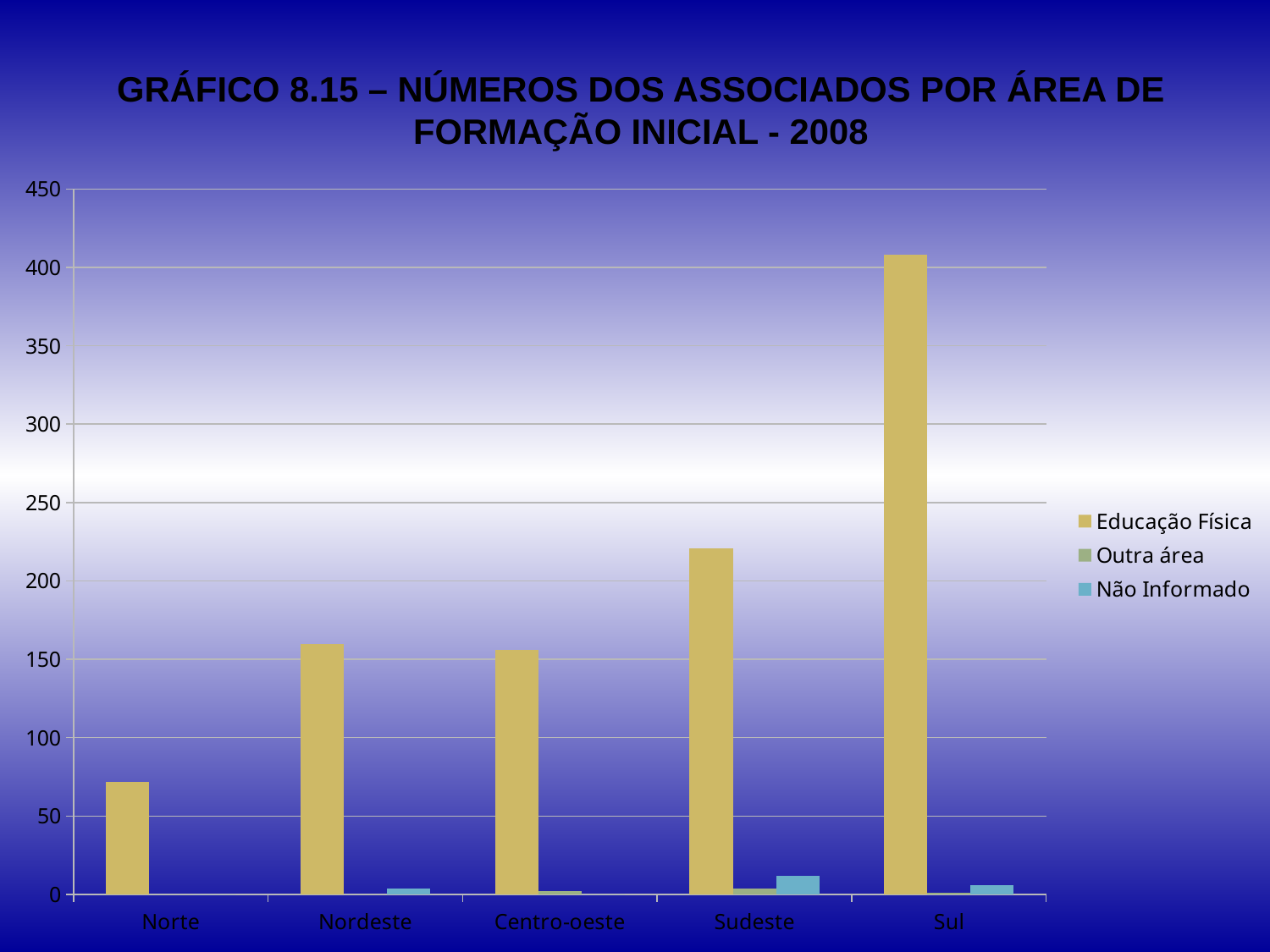
Which region has the highest value for Educação Física? Sul Which region has the lowest value for Educação Física? Norte Is the Educação Física value for Norte greater or less than 100? less What kind of chart is shown on the slide? bar chart How many series does the legend list? 3 Is the Educação Física value for Sudeste greater or less than 200? greater How many regions are shown on the x axis? 5 What are the three series listed in the legend? Educação Física, Outra área, Não Informado Is the Educação Física value for Sul greater or less than 400? greater Which region has the highest value for Não Informado? Sudeste Which is larger for Educação Física: Sudeste or Norte? Sudeste